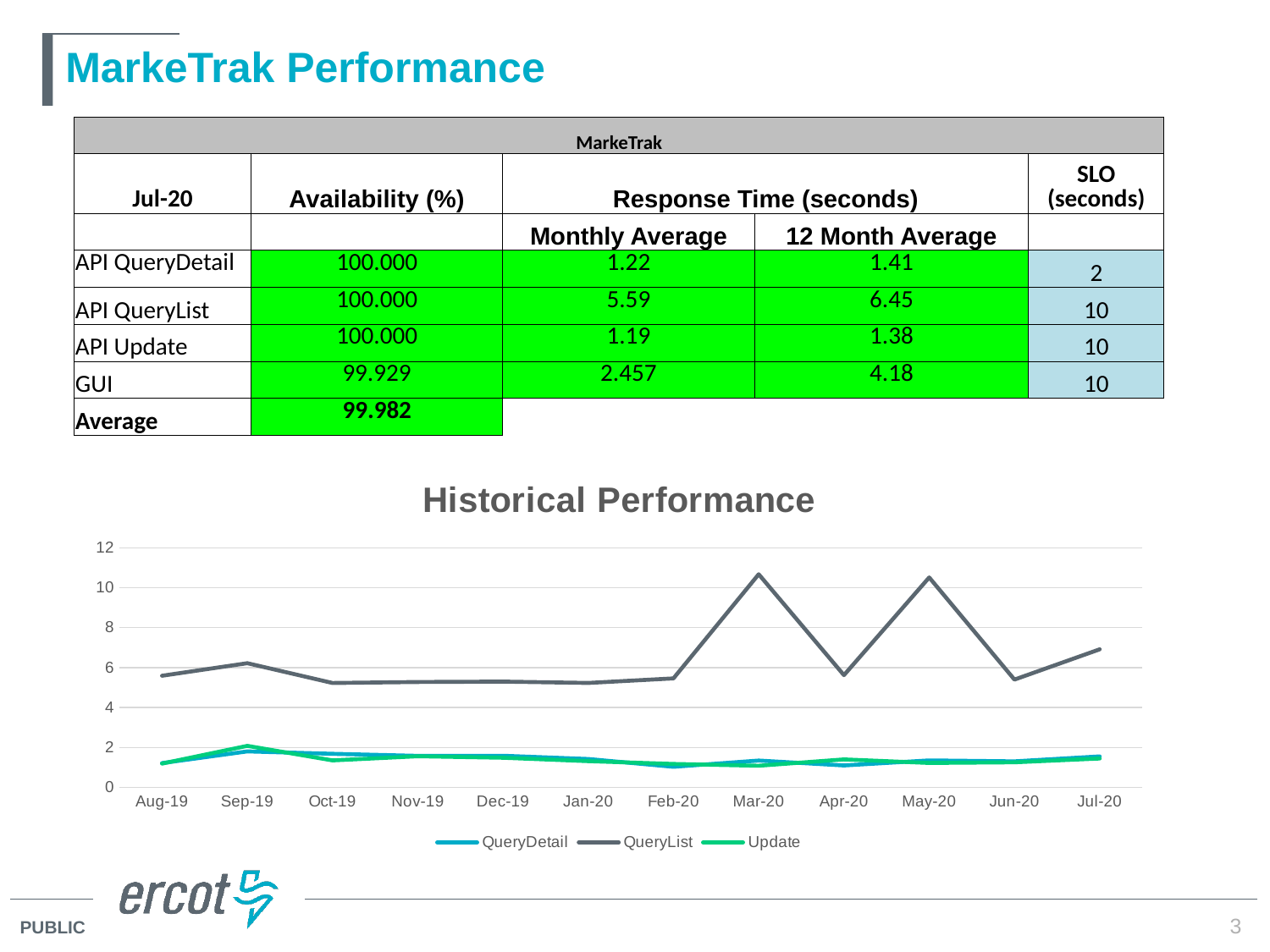
What are the first and last months shown on the x axis of the Historical Performance chart? Aug-19 and Jul-20 What is the title of the line chart on the slide? Historical Performance In the Historical Performance chart, is the Update value for Sep-19 greater or less than 1? greater In the Historical Performance chart, which series has the highest values across the whole period? QueryList In the Historical Performance chart, is the QueryList value for Jan-20 greater or less than 6? less How many series does the legend of the Historical Performance chart list? 3 In the Historical Performance chart, is the QueryList value for Jul-20 greater or less than 6? greater In the Historical Performance chart, which series has the larger value at Mar-20, QueryList or Update? QueryList What kind of chart is the Historical Performance chart? line chart How many months are plotted along the x axis of the Historical Performance chart? 12 In the Historical Performance chart, does the QueryList series rise or fall from Jan-20 to Mar-20? rise